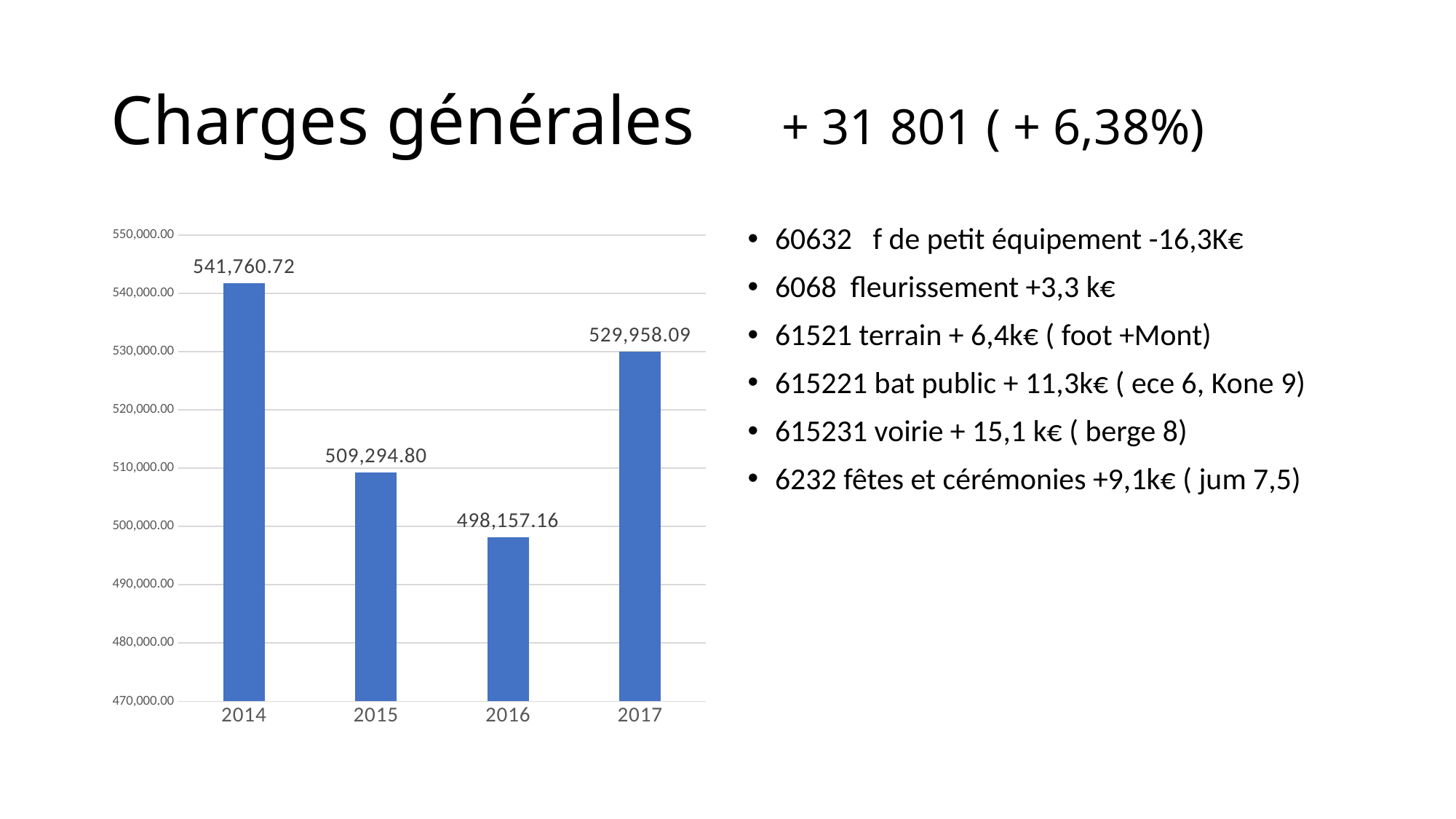
Which year has the highest value? 2014 What is the value for 2015? 509,294.80 What is the value for 2014? 541,760.72 What is the difference between the values for 2017 and 2016? 31,800.93 What is the value for 2016? 498,157.16 Which is larger, the value for 2015 or the value for 2017? 2017 How many years are shown on the x axis? 4 What is the difference between the values for 2014 and 2015? 32,465.92 What is the value for 2017? 529,958.09 Which year has the lowest value? 2016 Is the value for 2016 greater or less than 500,000.00? less What kind of chart is shown on the slide? bar chart